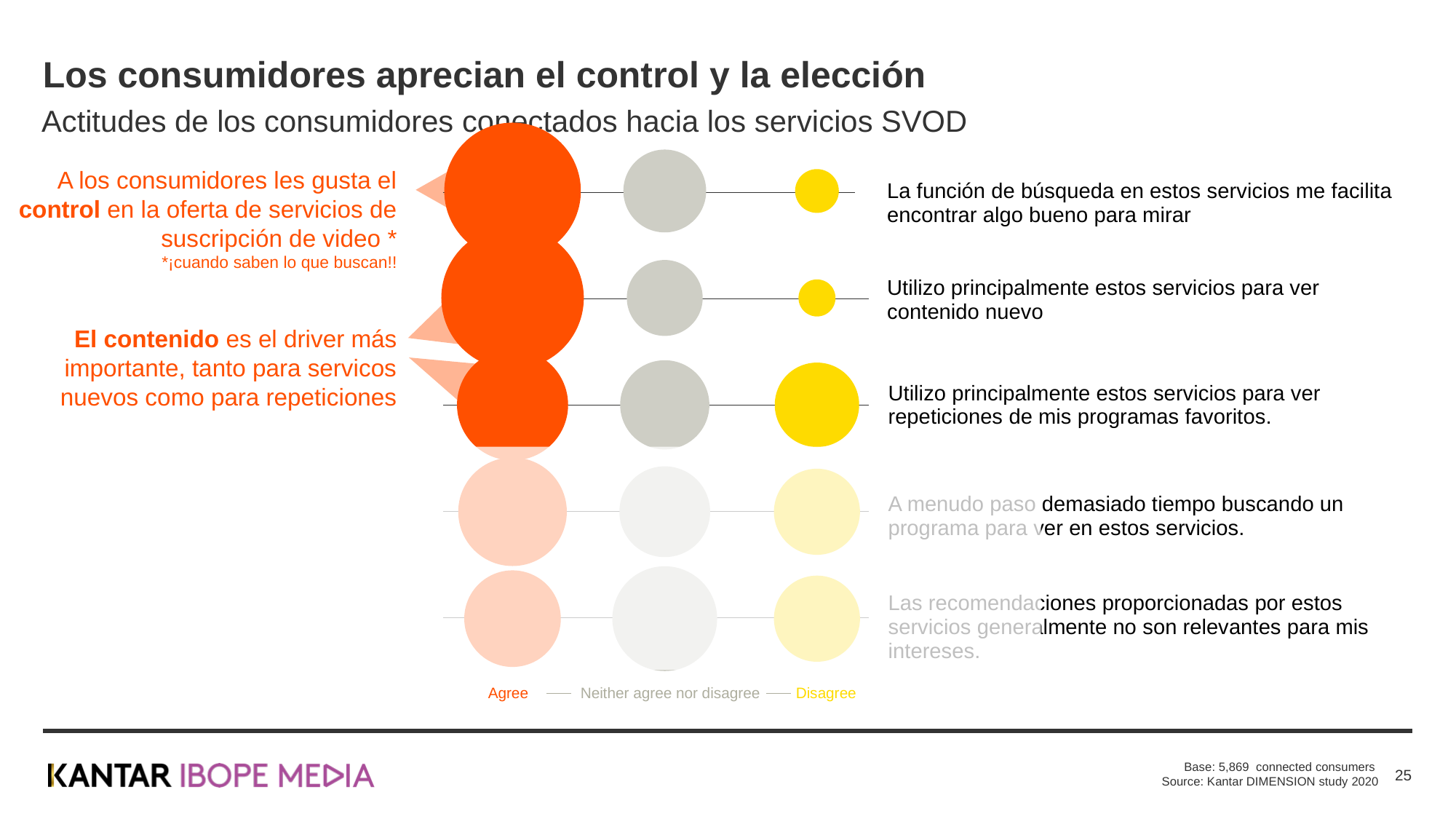
For the statement 'Utilizo principalmente estos servicios para ver contenido nuevo', which is larger: the Agree bubble or the Disagree bubble? Agree Which colour represents 'Agree' in the chart? Orange How many response categories does the legend list? 3 For the statement 'La función de búsqueda en estos servicios me facilita encontrar algo bueno para mirar', which is larger: the Agree bubble or the Disagree bubble? Agree How many attitude statements are plotted in the chart? 5 Which statement has the largest Disagree bubble? Utilizo principalmente estos servicios para ver repeticiones de mis programas favoritos. For the statement 'La función de búsqueda en estos servicios me facilita encontrar algo bueno para mirar', which is larger: the Neither agree nor disagree bubble or the Disagree bubble? Neither agree nor disagree What are the three legend entries of the chart? Agree, Neither agree nor disagree, Disagree What kind of chart is shown on the slide? Bubble chart